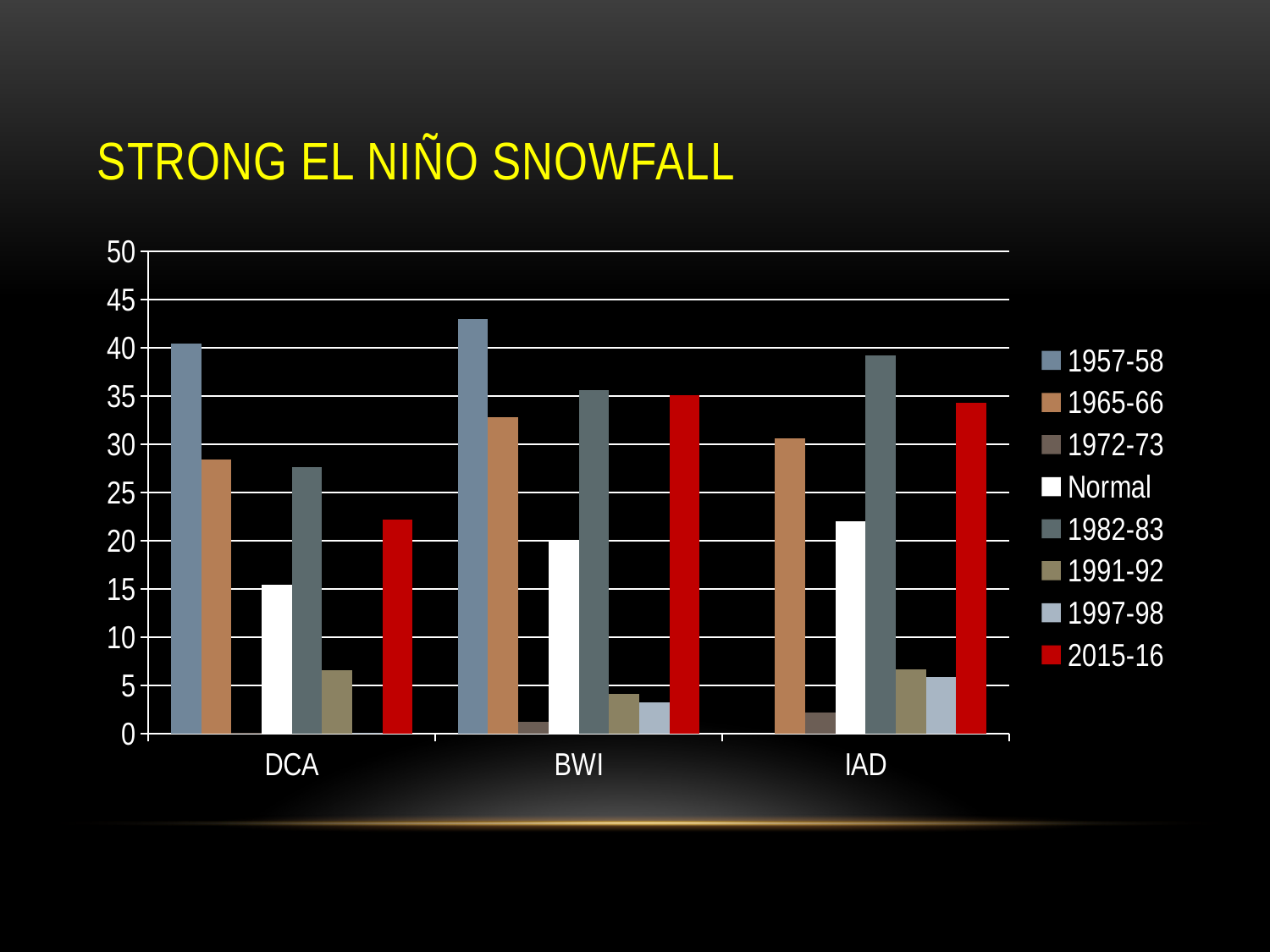
Is the Normal value for DCA greater or less than 20? less Which category has the tallest 1957-58 bar? BWI What is the title of the chart? Strong El Niño Snowfall Is the 2015-16 value for IAD greater or less than 30? greater How many series does the legend list? 8 Which category has the shortest 2015-16 bar? DCA Is the 1957-58 value for BWI greater or less than 40? greater Which category has the tallest 1982-83 bar? IAD What kind of chart is shown on the slide? bar chart How many airport categories are shown on the x axis? 3 Which series is drawn in red? 2015-16 For DCA, which is larger, the 1965-66 value or the 2015-16 value? 1965-66